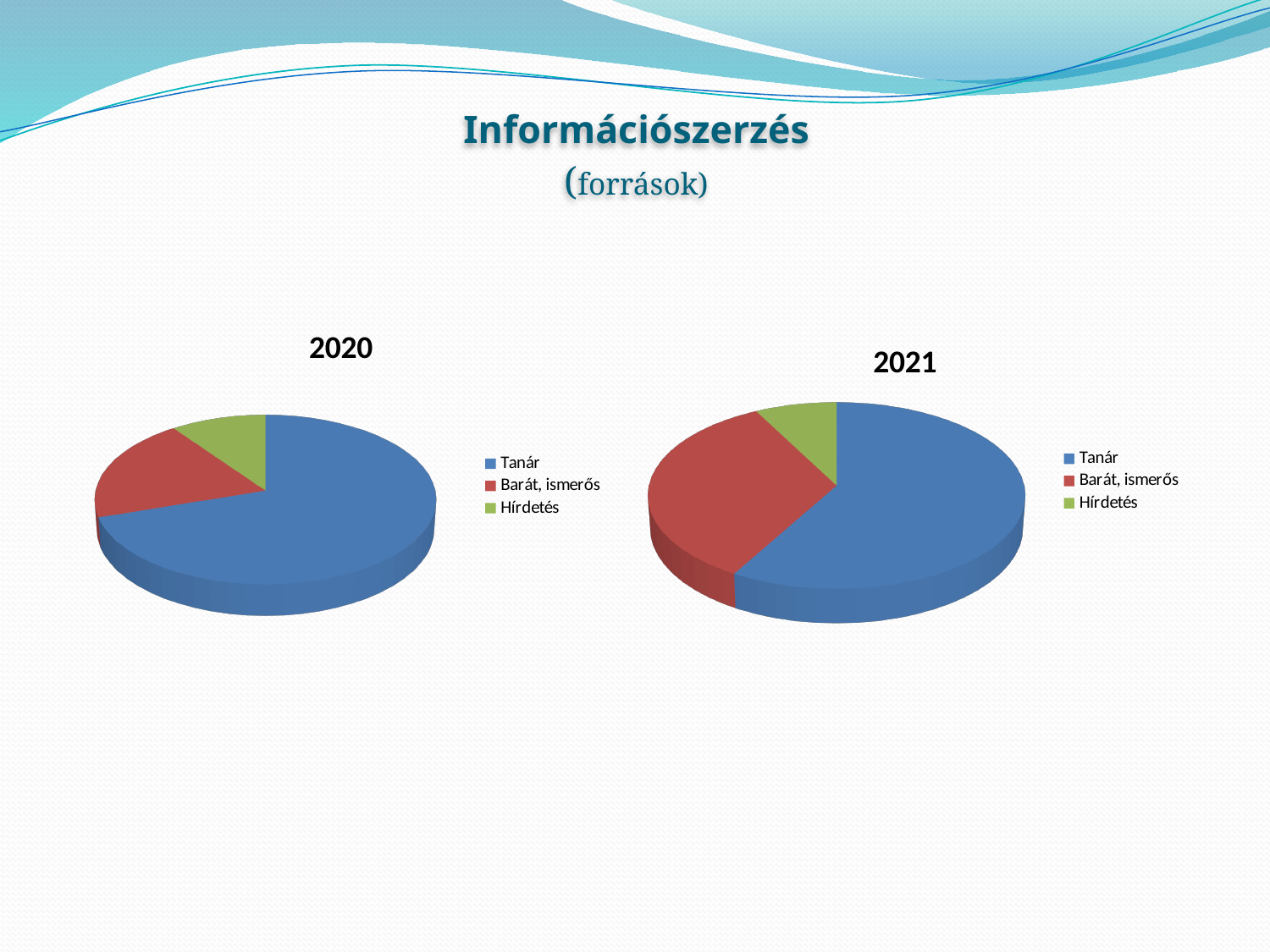
In the chart titled 2021, which category has the largest slice? Tanár In the chart titled 2021, which category has the smallest slice? Hírdetés In the chart titled 2021, which slice is larger: Barát, ismerős or Hírdetés? Barát, ismerős What kind of chart is the chart titled 2021? pie chart In the chart titled 2020, which slice is larger: Tanár or Barát, ismerős? Tanár How many categories does the chart titled 2020 show? 3 In the chart titled 2020, which category has the largest slice? Tanár In the chart titled 2020, which category has the smallest slice? Hírdetés What kind of chart is the chart titled 2020? pie chart How many entries does the legend of the chart titled 2021 list? 3 In the chart titled 2021, what colour is the Hírdetés slice? green What are the titles of the two pie charts on the slide? 2020 and 2021